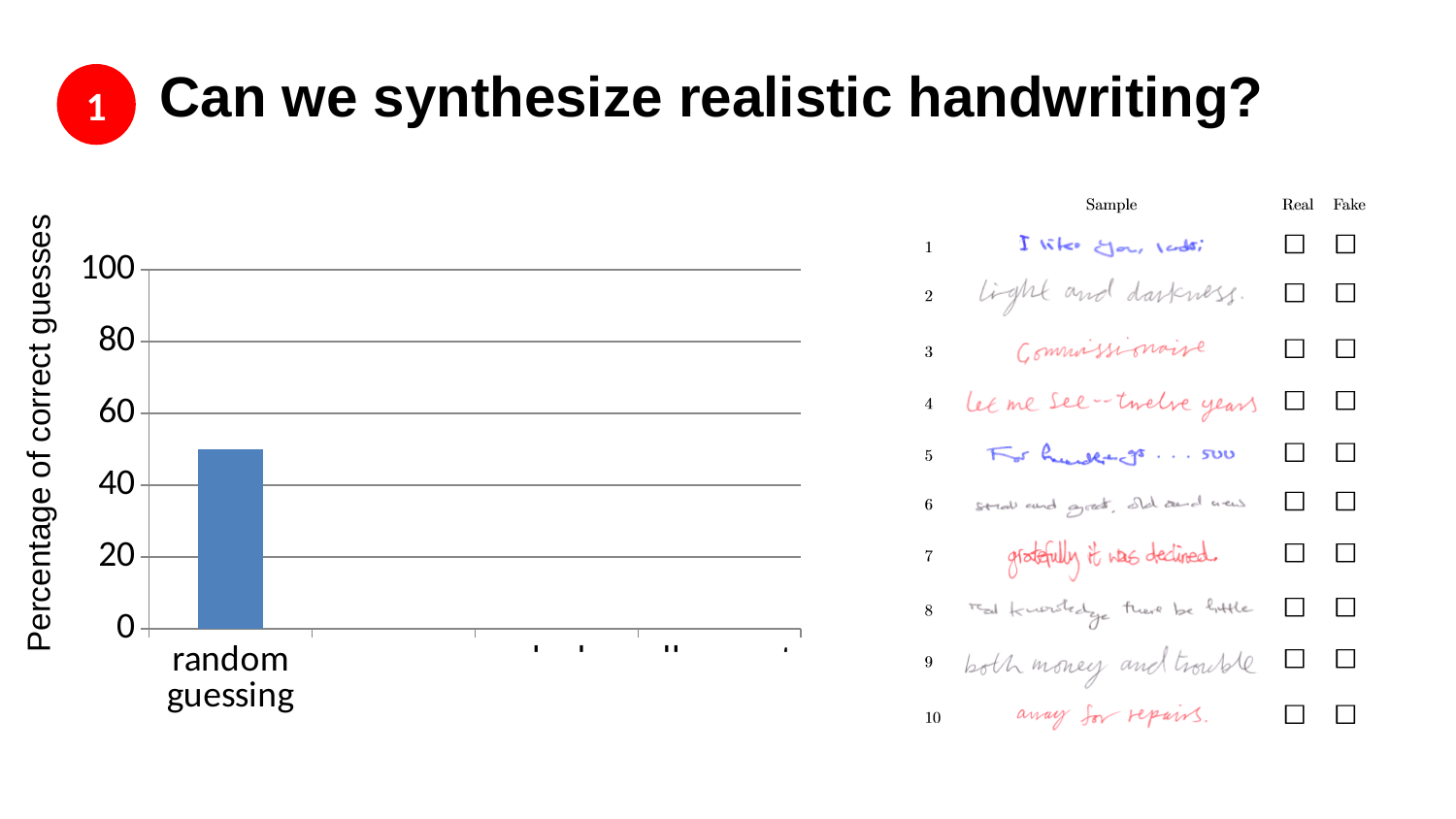
Is the value for random guessing greater or less than 20? greater Is the value for random guessing greater or less than 80? less Is the value for random guessing greater or less than 60? less What is the title of the vertical axis of the chart? Percentage of correct guesses What kind of chart is shown on the slide? bar chart What is the highest value shown on the vertical axis of the chart? 100